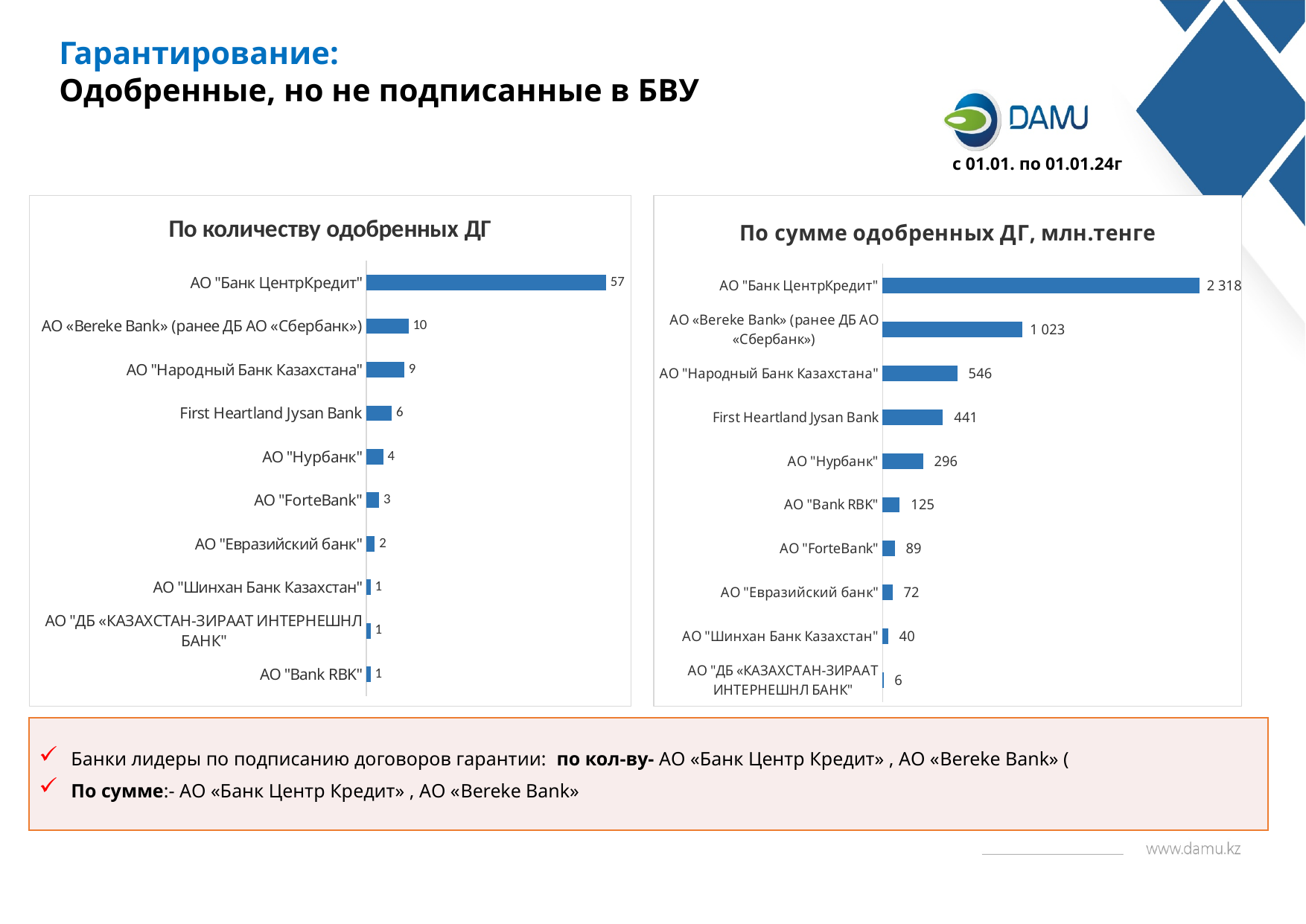
In the chart "По количеству одобренных ДГ", what is the value for АО "Банк ЦентрКредит"? 57 In the chart "По сумме одобренных ДГ, млн.тенге", which is larger: АО "Нурбанк" or First Heartland Jysan Bank? First Heartland Jysan Bank In the chart "По сумме одобренных ДГ, млн.тенге", what is the value for АО "Народный Банк Казахстана"? 546 In the chart "По сумме одобренных ДГ, млн.тенге", what is the difference between АО "Банк ЦентрКредит" and АО «Bereke Bank» (ранее ДБ АО «Сбербанк»)? 1 295 What is the title of the chart on the left side of the slide? По количеству одобренных ДГ What type of chart is "По сумме одобренных ДГ, млн.тенге"? Bar chart In the chart "По количеству одобренных ДГ", what is the difference between АО «Bereke Bank» (ранее ДБ АО «Сбербанк») and АО "Народный Банк Казахстана"? 1 In the chart "По количеству одобренных ДГ", which bank has the highest value? АО "Банк ЦентрКредит" In the chart "По сумме одобренных ДГ, млн.тенге", what is the value for АО "Bank RBK"? 125 In the chart "По количеству одобренных ДГ", what is the value for First Heartland Jysan Bank? 6 In the chart "По количеству одобренных ДГ", how many banks are shown? 10 In the chart "По сумме одобренных ДГ, млн.тенге", which bank has the lowest value? АО "ДБ «КАЗАХСТАН-ЗИРААТ ИНТЕРНЕШНЛ БАНК"